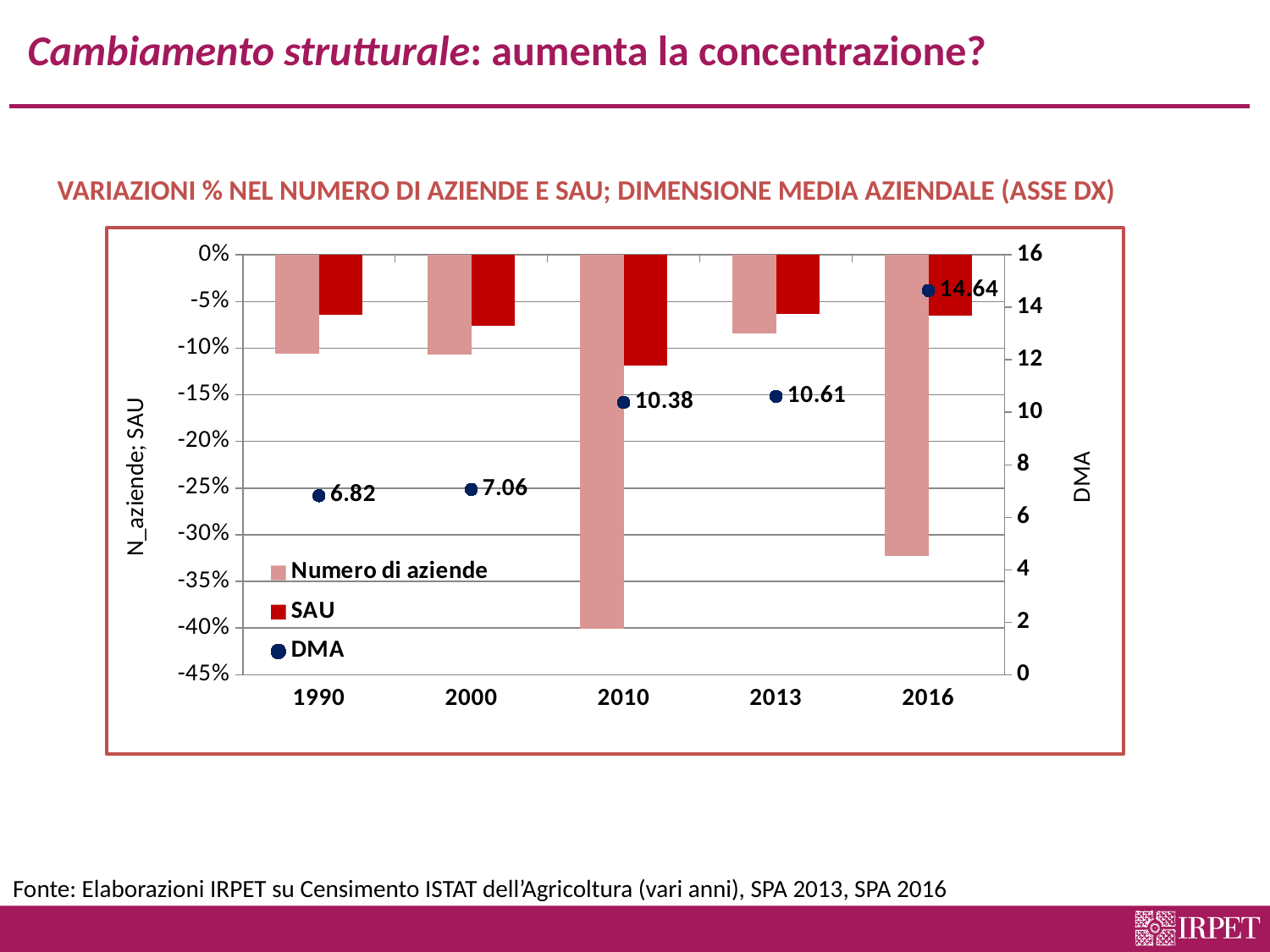
In which year is the DMA value highest? 2016 What is the DMA value for 1990? 6.82 Does the DMA value rise or fall from 1990 to 2016? rise Is the value for SAU in 2010 greater or less than -10%? less In which year is the DMA value lowest? 1990 What is the DMA value for 2016? 14.64 What is the DMA value for 2010? 10.38 How many years are shown on the x axis? 5 What is the difference between the DMA value in 2016 and in 1990? 7.82 Which year has the larger DMA value, 2000 or 2013? 2013 Is the value for Numero di aziende in 2010 greater or less than -35%? less How many series does the legend list? 3